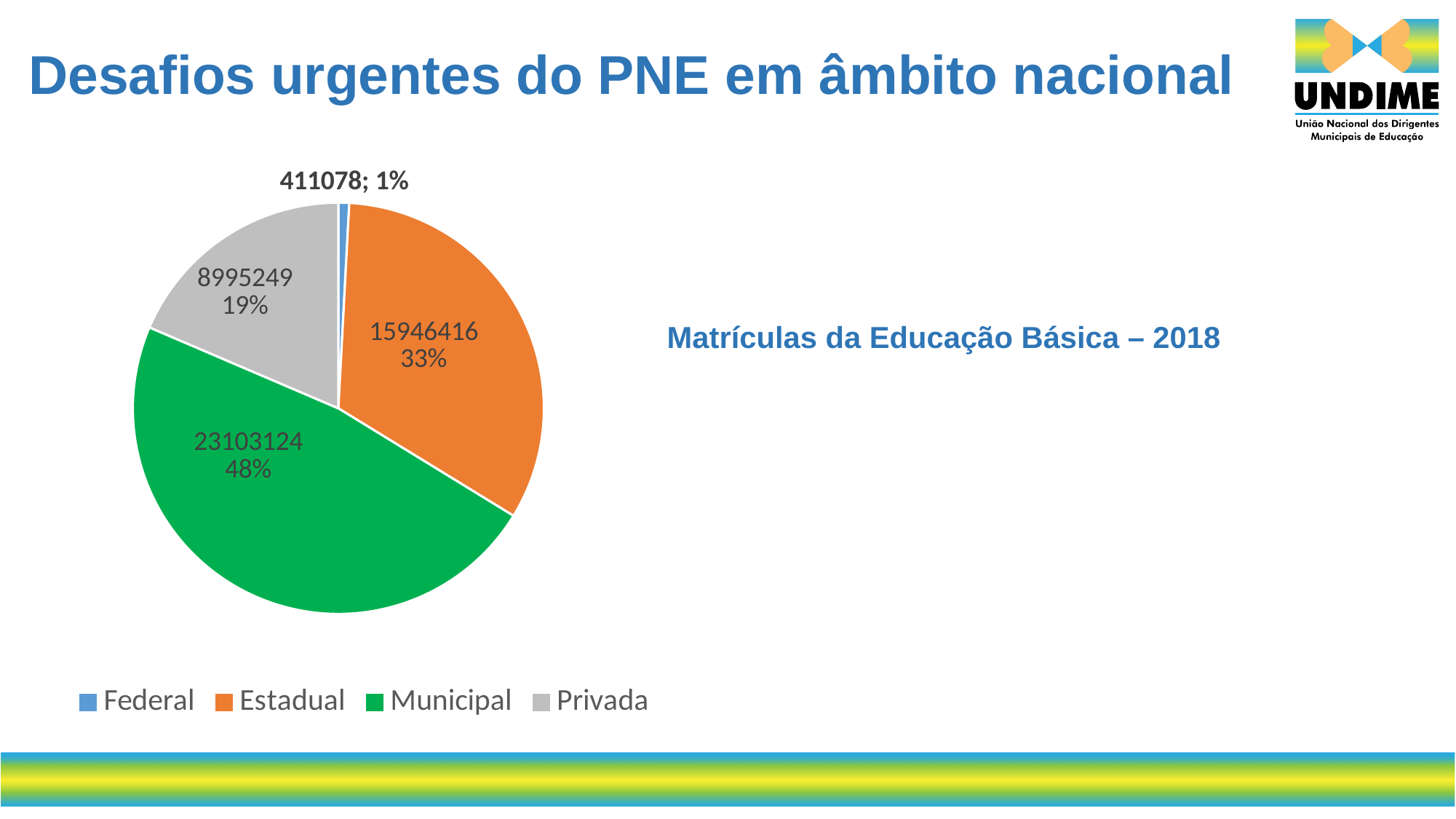
Which category has the smallest slice in the pie chart? Federal What type of chart is shown on the slide? pie chart How many entries does the legend of the pie chart list? 4 Which colour represents Estadual in the pie chart? orange What percentage share does Privada have in the pie chart? 19% What is the value shown for Estadual in the pie chart? 15946416 What is the value shown for Federal in the pie chart? 411078 What is the value shown for Municipal in the pie chart? 23103124 Which category has the largest slice in the pie chart? Municipal What is the difference between the Municipal and Estadual values in the pie chart? 7156708 What percentage share does Municipal have in the pie chart? 48% How many slices does the pie chart have? 4